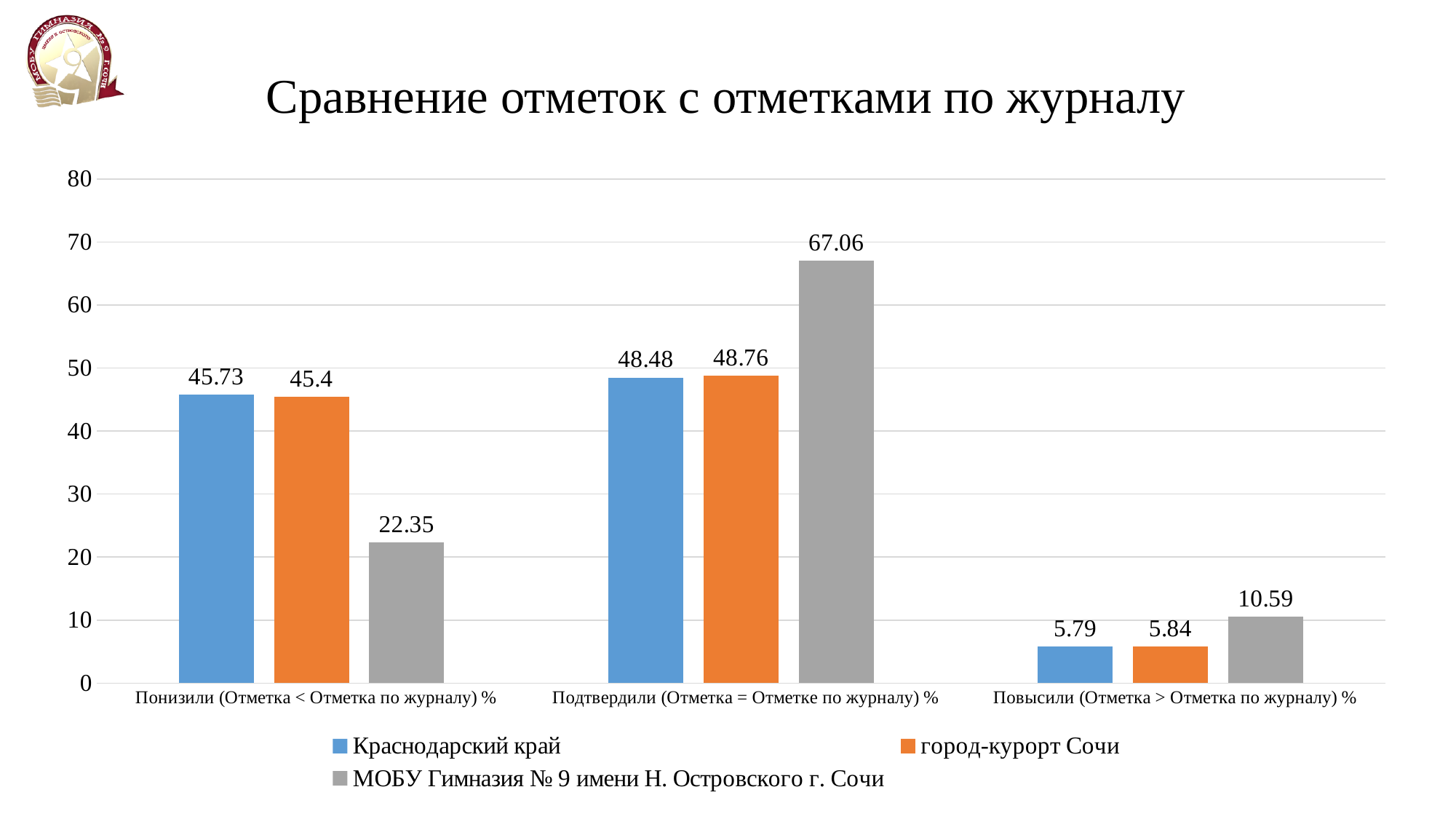
What is the title of the slide? Сравнение отметок с отметками по журналу In the Повысили (Отметка > Отметка по журналу) % category, which is larger: the value for МОБУ Гимназия № 9 or the value for Краснодарский край? МОБУ Гимназия № 9 имени Н. Островского г. Сочи Is the value for город-курорт Сочи in the Понизили (Отметка < Отметка по журналу) % category greater or less than 40? greater What is the value for Краснодарский край in the Понизили (Отметка < Отметка по журналу) % category? 45.73 What kind of chart is shown on the slide? bar chart How many series does the legend list? 3 Which series has the lowest value in the Понизили (Отметка < Отметка по журналу) % category? МОБУ Гимназия № 9 имени Н. Островского г. Сочи What is the value for МОБУ Гимназия № 9 имени Н. Островского г. Сочи in the Подтвердили (Отметка = Отметке по журналу) % category? 67.06 Which series has the highest value in the Подтвердили (Отметка = Отметке по журналу) % category? МОБУ Гимназия № 9 имени Н. Островского г. Сочи How many categories are shown on the x axis? 3 What is the difference between the МОБУ Гимназия № 9 value and the Краснодарский край value in the Подтвердили (Отметка = Отметке по журналу) % category? 18.58 What is the value for город-курорт Сочи in the Повысили (Отметка > Отметка по журналу) % category? 5.84